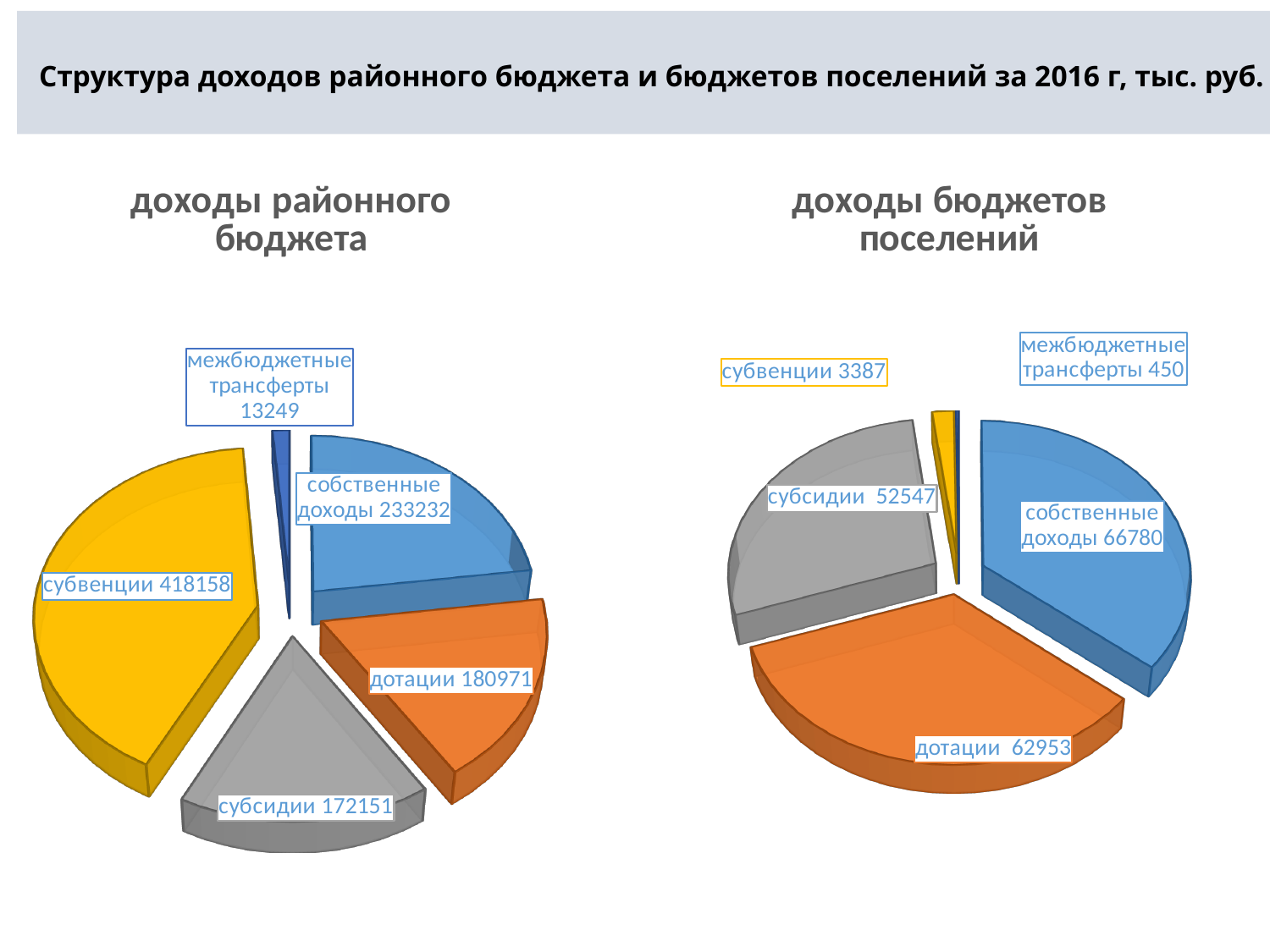
In the chart titled "доходы бюджетов поселений", what is the difference between собственные доходы and дотации? 3827 What kind of chart is the chart titled "доходы районного бюджета"? pie chart In the chart titled "доходы районного бюджета", what is the value for субвенции? 418158 What is the title of the slide? Структура доходов районного бюджета и бюджетов поселений за 2016 г, тыс. руб. In the chart titled "доходы районного бюджета", what is the difference between субвенции and собственные доходы? 184926 In the chart titled "доходы бюджетов поселений", what is the value for субсидии? 52547 In the chart titled "доходы районного бюджета", which is larger: дотации or субсидии? дотации In the chart titled "доходы бюджетов поселений", what is the value for собственные доходы? 66780 How many categories are shown in the chart titled "доходы бюджетов поселений"? 5 In the chart titled "доходы районного бюджета", what is the value for межбюджетные трансферты? 13249 In the chart titled "доходы бюджетов поселений", which category has the smallest value? межбюджетные трансферты In the chart titled "доходы районного бюджета", which category has the largest value? субвенции